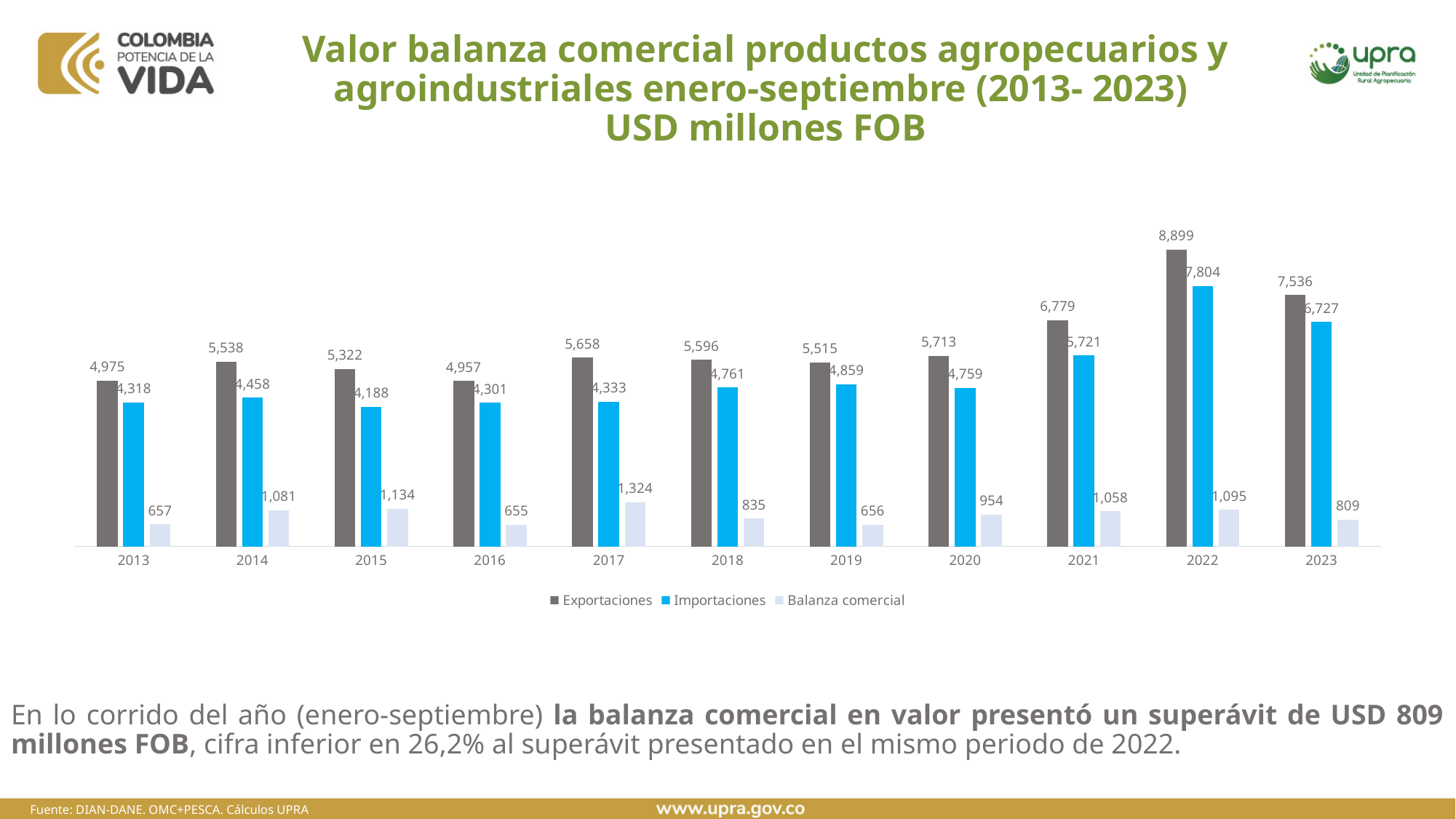
In which year is Exportaciones highest? 2022 Which is larger, Importaciones in 2022 or Exportaciones in 2023? Importaciones in 2022 What is the value of Exportaciones in 2022? 8,899 What is the value of Importaciones in 2023? 6,727 What is the difference between Exportaciones and Importaciones in 2023? 809 In which year is Balanza comercial highest? 2017 What is the difference between Exportaciones in 2022 and Exportaciones in 2021? 2,120 What kind of chart is shown on the slide? Bar chart How many years are shown on the x axis? 11 What is the value of Importaciones in 2015? 4,188 How many series does the legend list? 3 What is the value of Balanza comercial in 2017? 1,324